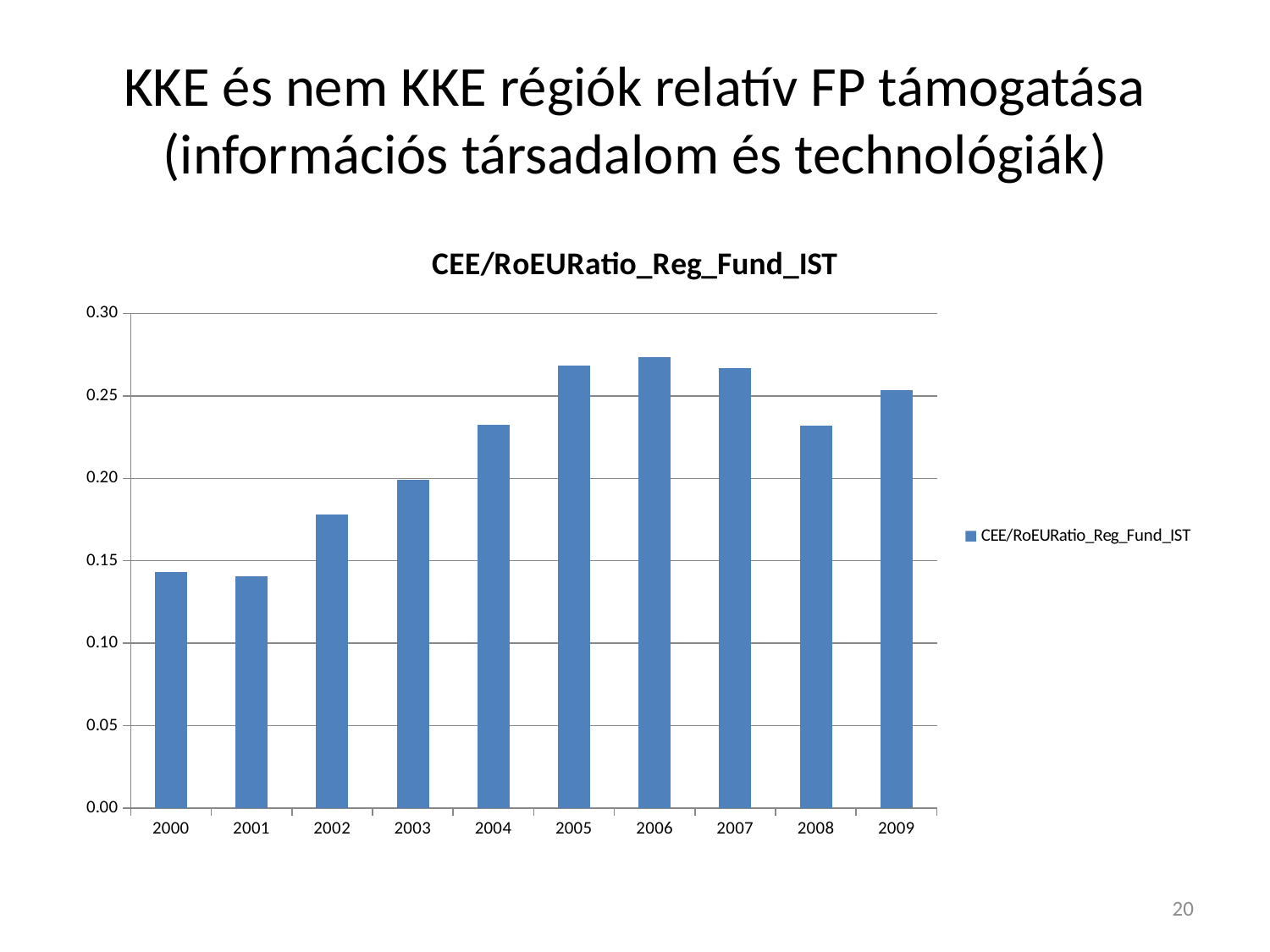
Is the value for 2005 greater or less than 0.25? greater Do the values rise or fall from 2001 to 2006? rise Is the value for 2008 greater or less than 0.25? less How many series does the chart legend list? 1 Which year has the larger value, 2006 or 2000? 2006 Is the value for 2004 greater or less than 0.20? greater Which year has the larger value, 2009 or 2008? 2009 How many years are shown on the x axis of the chart? 10 What kind of chart is shown on the slide? bar chart What is the title of the chart? CEE/RoEURatio_Reg_Fund_IST